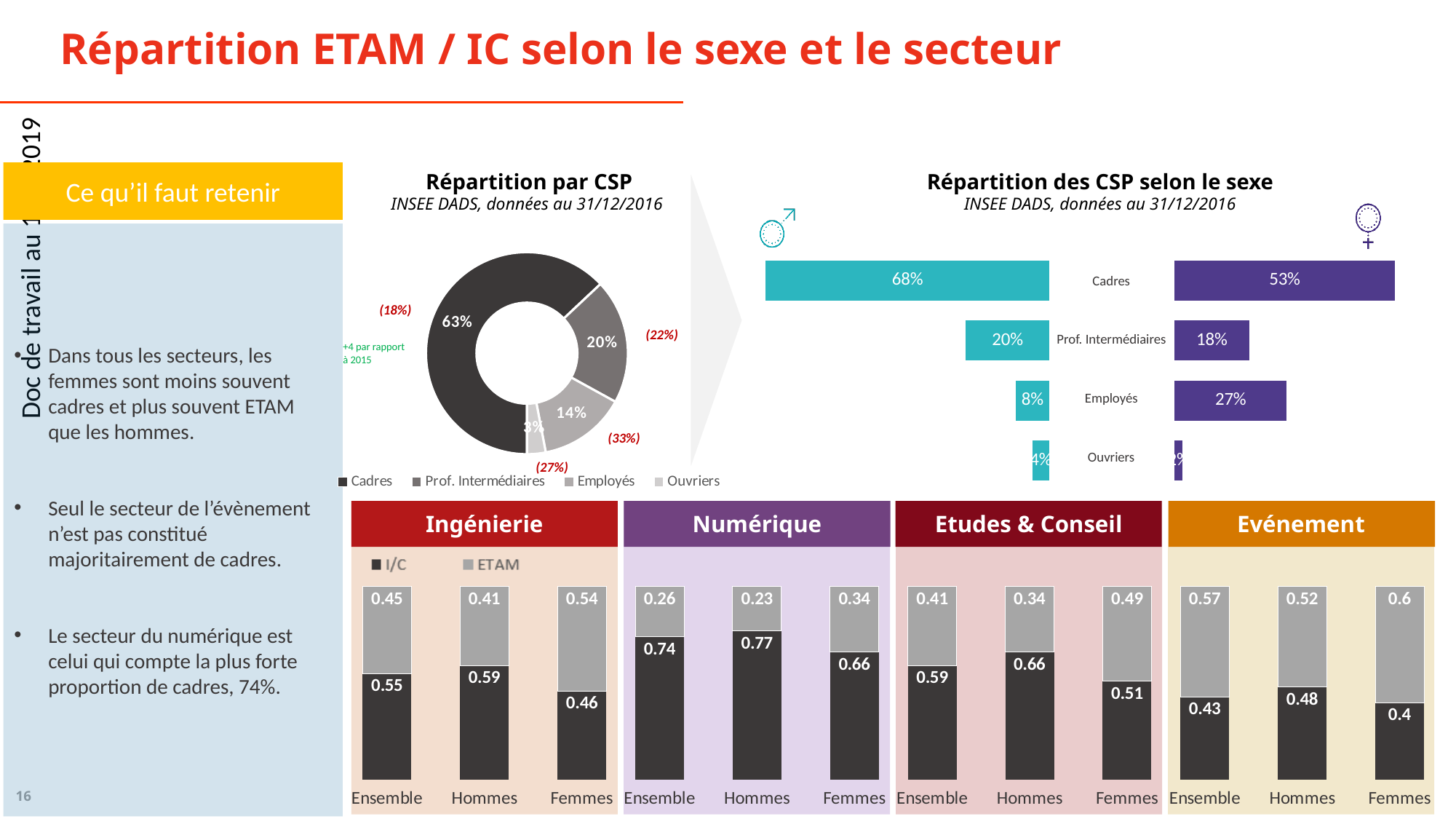
In the 'Répartition des CSP selon le sexe' chart, what is the value for Cadres on the men's (left) side? 68% In the 'Ingénierie' chart, what is the ETAM value for Femmes? 0.54 In the 'Evénement' chart, what is the total of the stacked bar for Hommes? 1 In the 'Numérique' chart, what is the I/C value for Ensemble? 0.74 In the 'Répartition des CSP selon le sexe' chart, what is the value for Employés on the women's (right) side? 27% In the 'Etudes & Conseil' chart, which group has the highest I/C value? Hommes In the 'Répartition des CSP selon le sexe' chart, is the Employés value larger for men or for women? Women In the 'Répartition par CSP' donut chart, which category has the smallest share? Ouvriers In the 'Répartition par CSP' donut chart, what share is shown for Cadres? 63% What type of chart is used for the 'Ingénierie', 'Numérique', 'Etudes & Conseil' and 'Evénement' panels? Stacked bar chart How many categories does the legend of the 'Répartition par CSP' donut chart list? 4 In the 'Répartition des CSP selon le sexe' chart, what is the difference between the men's and women's values for Cadres? 15%